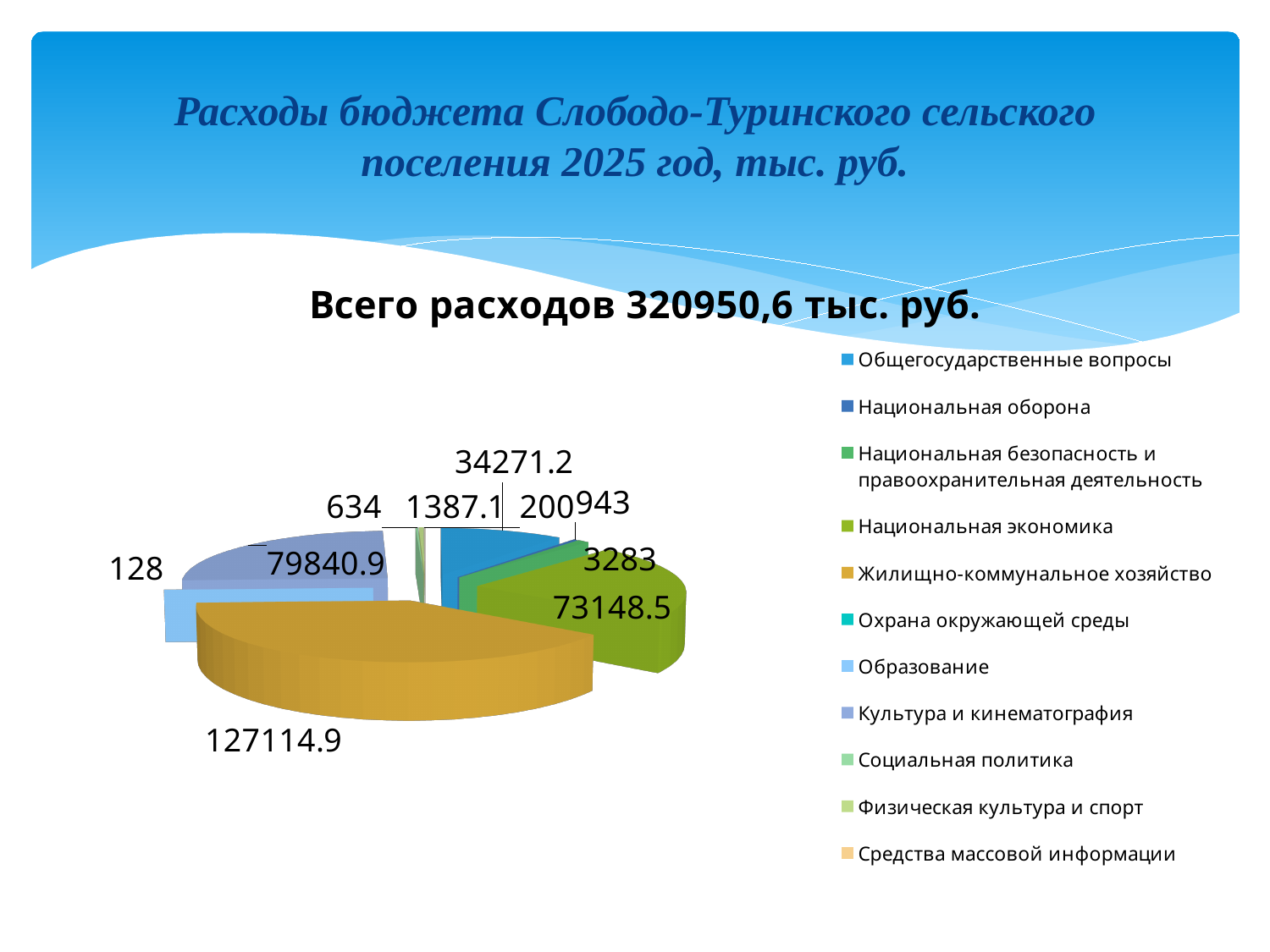
Which is larger, Национальная экономика or Культура и кинематография? Культура и кинематография How many categories does the chart legend list? 11 What is the title of the chart? Всего расходов 320950,6 тыс. руб. What is the difference between Жилищно-коммунальное хозяйство and Национальная экономика? 53966.4 What is the value for Общегосударственные вопросы? 34271.2 What is the value for Культура и кинематография? 79840.9 What kind of chart is shown on the slide? pie chart What is the value for Национальная экономика? 73148.5 What is the difference between Жилищно-коммунальное хозяйство and Культура и кинематография? 47274 What is the value for Жилищно-коммунальное хозяйство? 127114.9 Which category has the largest slice of the pie? Жилищно-коммунальное хозяйство What is the total of all expenditures shown in the chart title? 320950,6 тыс. руб.